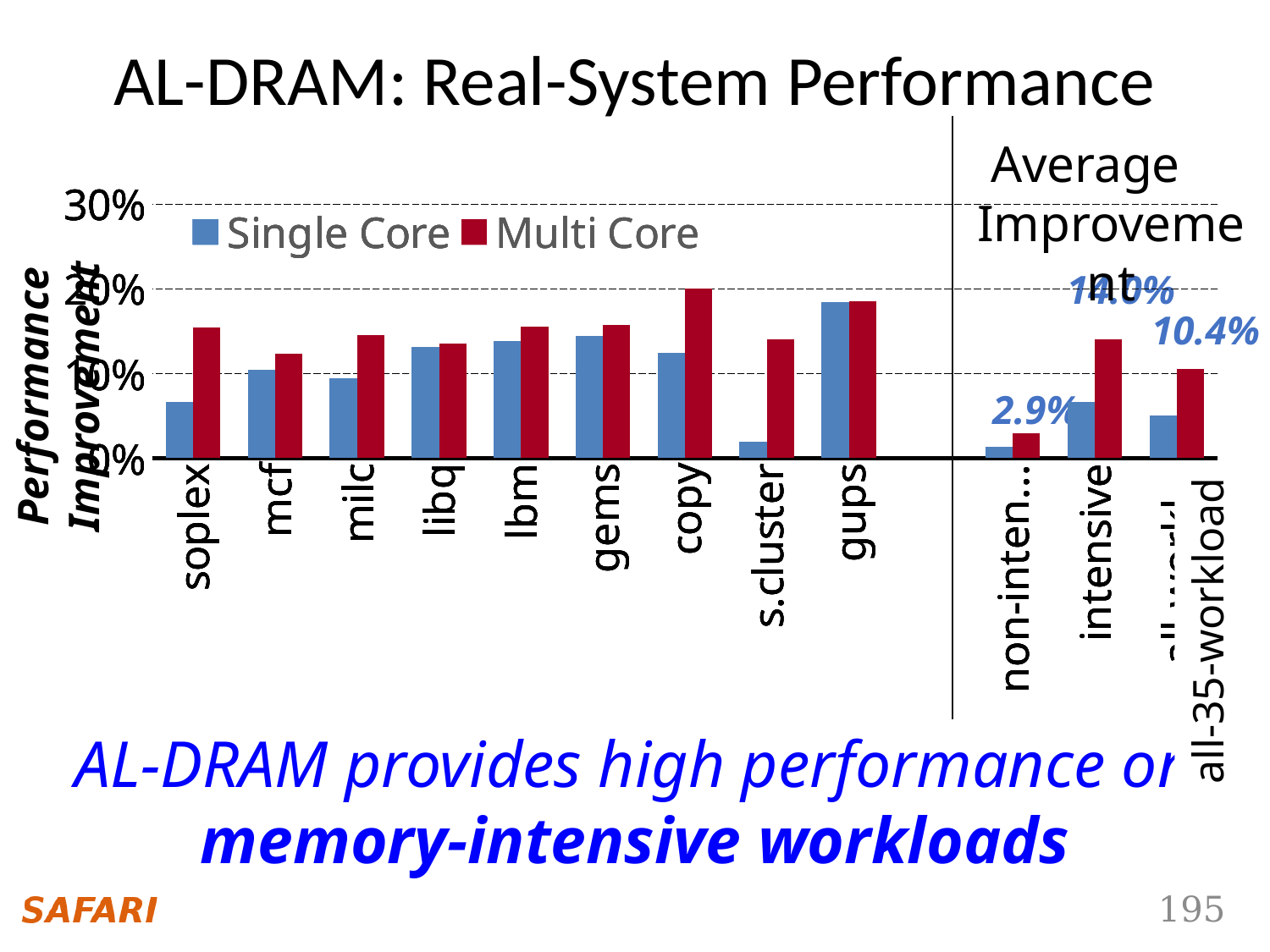
What kind of chart is shown on the slide? bar chart Which benchmark has the highest Multi Core performance improvement? copy For soplex, which is larger: the Single Core or the Multi Core improvement? Multi Core What is the Multi Core performance improvement for the intensive workload group? 14.0% How many series does the legend list? 2 What is the Multi Core performance improvement for all-35-workload? 10.4% How many individual benchmarks are plotted to the left of the vertical divider line? 9 Which benchmark has the highest Single Core performance improvement? gups What are the two series named in the legend? Single Core and Multi Core Is the Single Core value for s.cluster greater or less than 10%? less Is the Multi Core value for copy greater or less than 10%? greater What is the title of the slide containing the chart? AL-DRAM: Real-System Performance